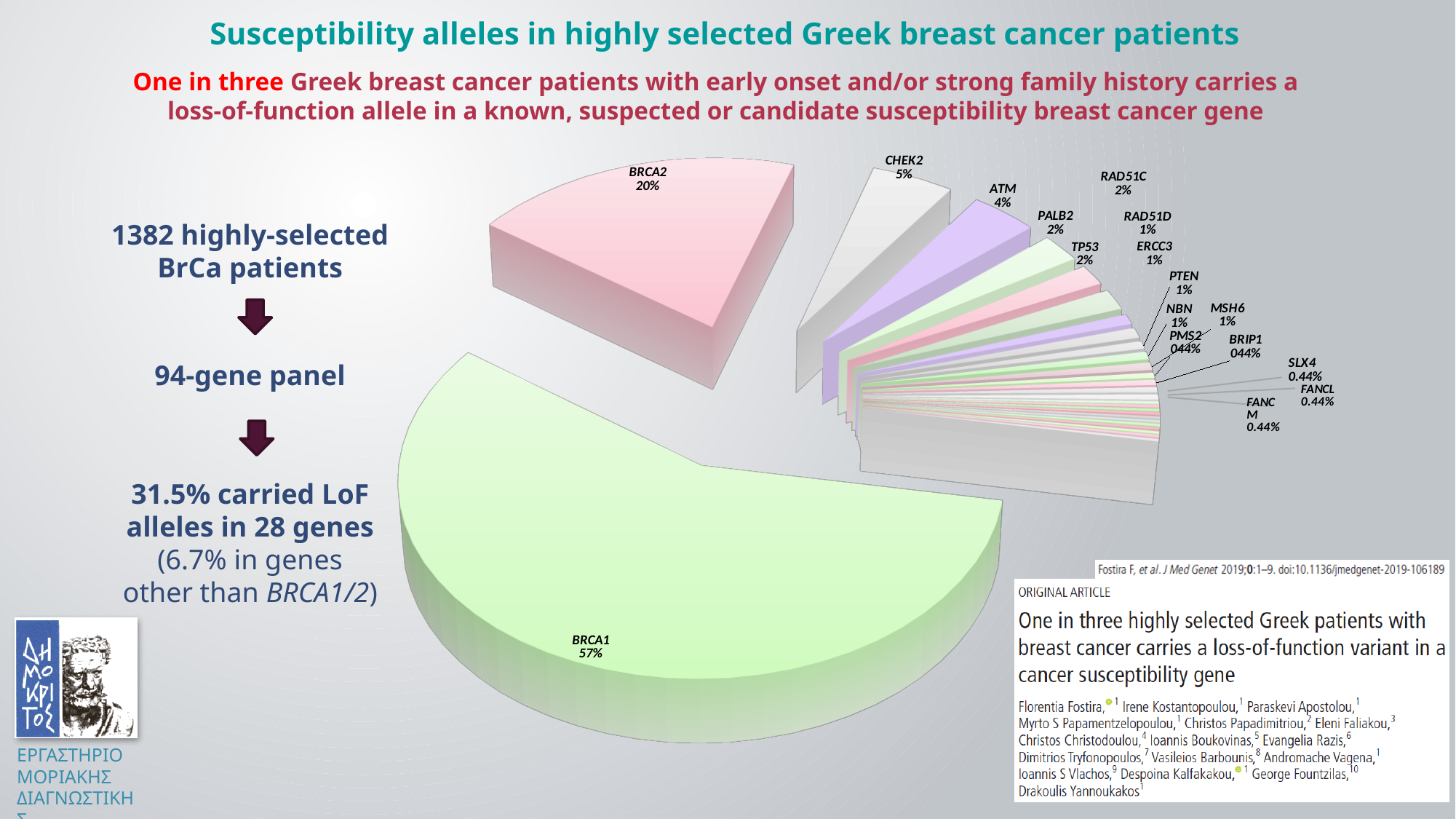
What is the title of the slide containing the pie chart? Susceptibility alleles in highly selected Greek breast cancer patients What is the value shown for SLX4? 0.44% What is the value shown for PALB2? 2% What is the value shown for ATM? 4% Which is larger, the slice for BRCA2 or the slice for CHEK2? BRCA2 What kind of chart is shown on the slide? pie chart What share of the pie does BRCA1 account for? 57% What is the combined percentage of BRCA1 and BRCA2? 77% What is the value shown for CHEK2? 5% What is the difference between the BRCA1 and BRCA2 percentages? 37% What is the value shown for BRCA2? 20% Which gene has the largest slice of the pie? BRCA1